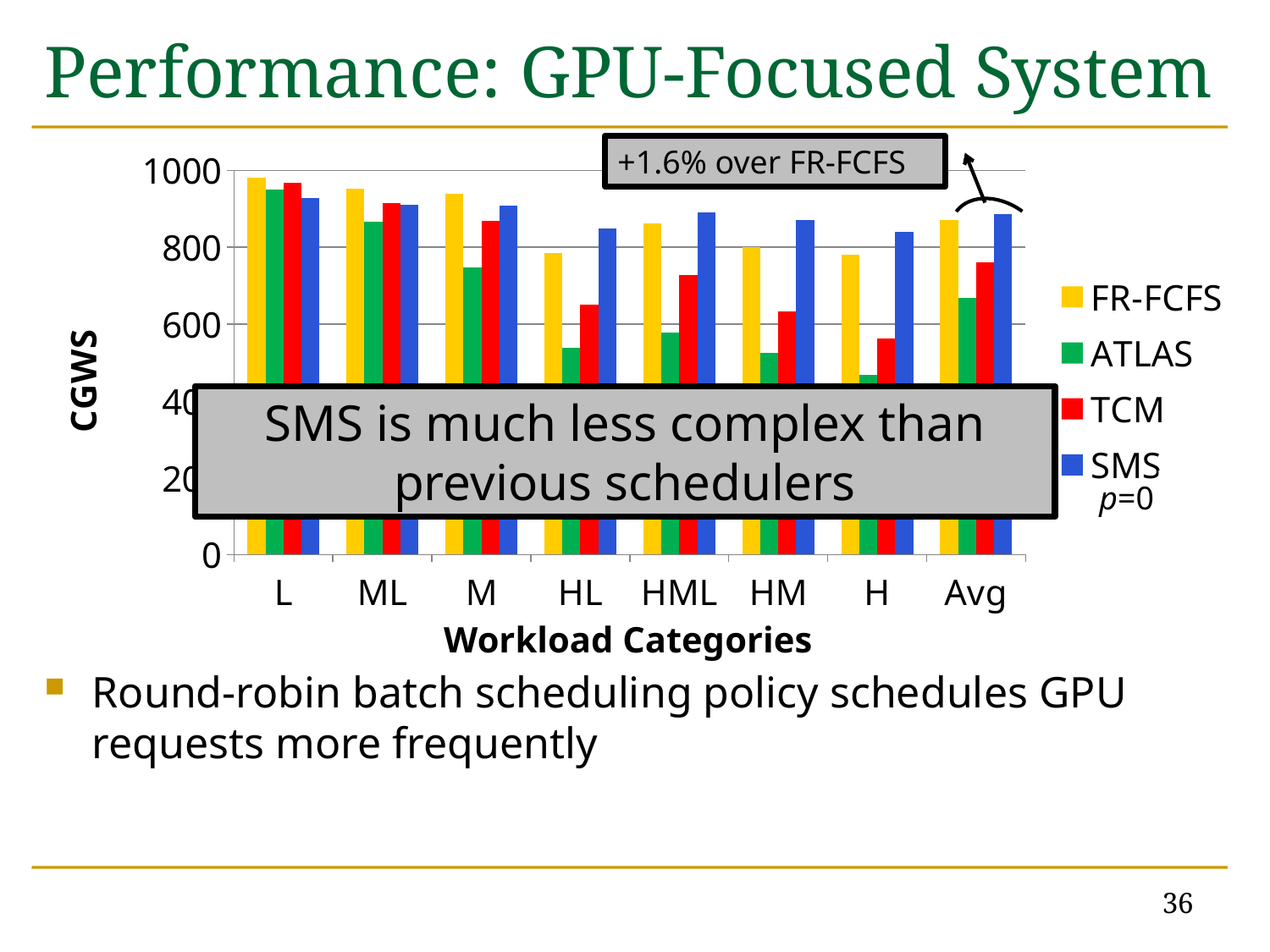
Is the ATLAS value for HL greater or less than 600? less For the HL category, which is larger, FR-FCFS or ATLAS? FR-FCFS How many workload categories are shown on the x axis? 8 How many series does the legend list? 4 What is the label of the y axis? CGWS Is the TCM value for HL greater or less than 600? greater Which series has the lowest value for the HM category? ATLAS Is the ATLAS value for M greater or less than 800? less What is the label of the x axis? Workload Categories For the H category, which is larger, SMS or TCM? SMS What kind of chart is shown on the slide? bar chart